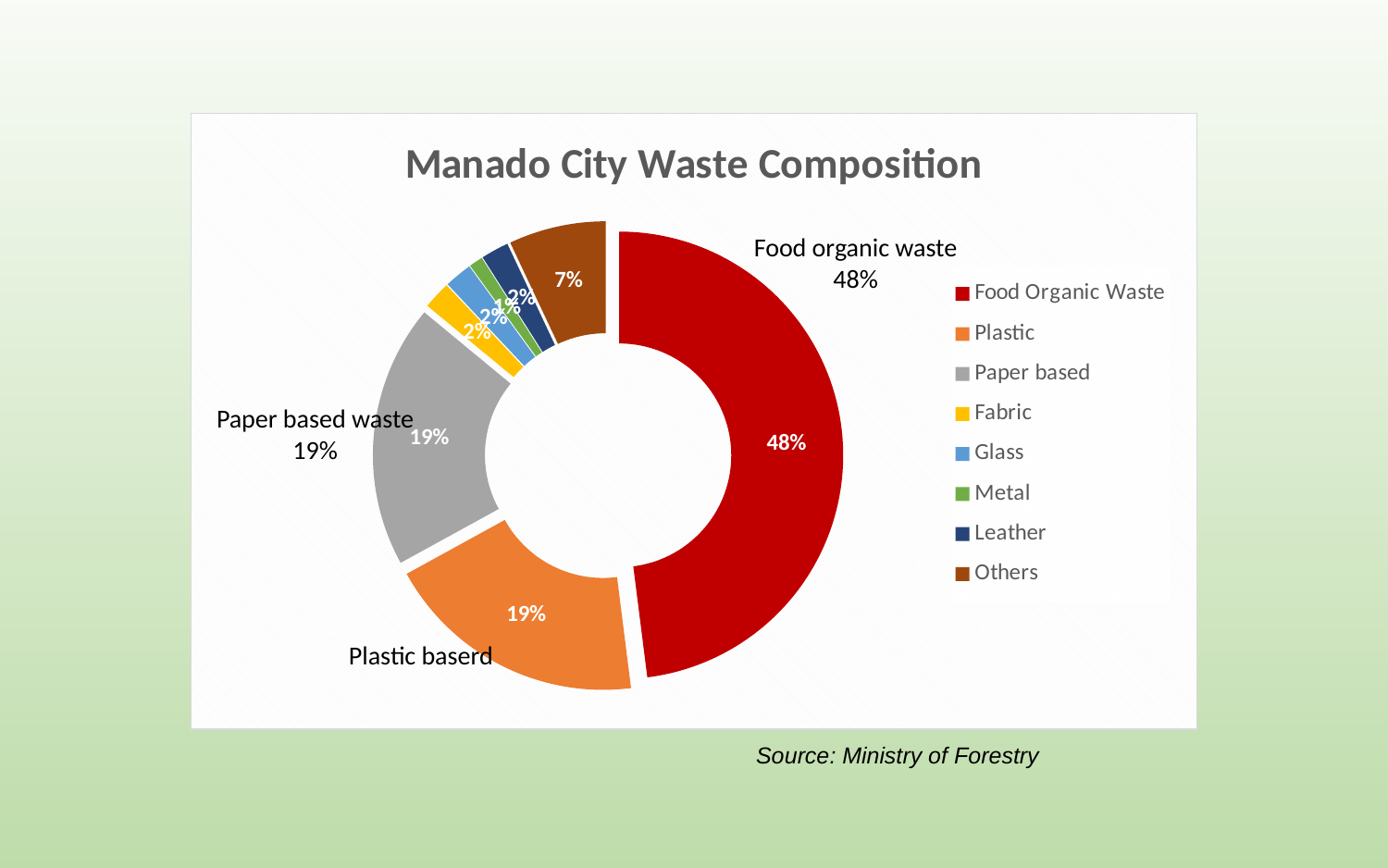
Which category makes up the largest share of Manado City waste? Food Organic Waste What percentage of the waste composition is Plastic? 19% How many categories does the legend list? 8 What share of the waste is labelled Others? 7% What kind of chart is shown on the slide? Doughnut (pie) chart What share of Manado City waste is Food Organic Waste? 48% Which is larger, the share for Others or the share for Fabric? Others What percentage of the waste composition is Paper based? 19% What is the title of the chart? Manado City Waste Composition What percentage of the waste is Fabric? 2% How many percentage points larger is the Food Organic Waste share than the Plastic share? 29 percentage points What is the combined share of Food Organic Waste, Plastic and Paper based? 86%